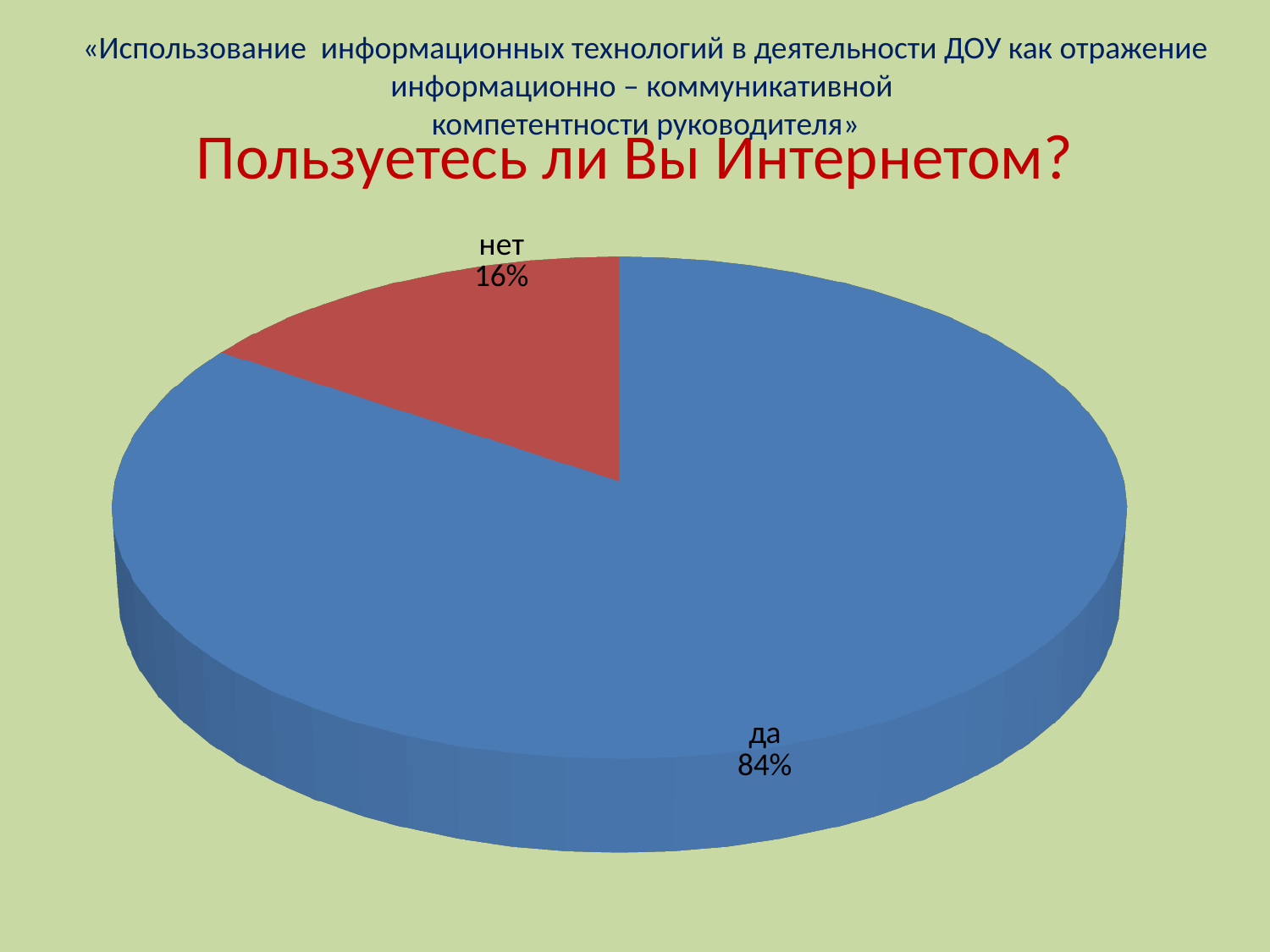
Which slice is larger, "да" or "нет"? да Which slice of the pie is the largest? да How many slices does the pie chart have? 2 What colour is the "нет" slice? red What share of the pie is labelled "нет"? 16% What is the difference in percentage points between the "да" and "нет" slices? 68 What question does the chart title ask? Пользуетесь ли Вы Интернетом? Which slice of the pie is the smallest? нет What kind of chart is shown on the slide? pie chart What share of the pie is labelled "да"? 84% What is the combined share of the "да" and "нет" slices? 100%